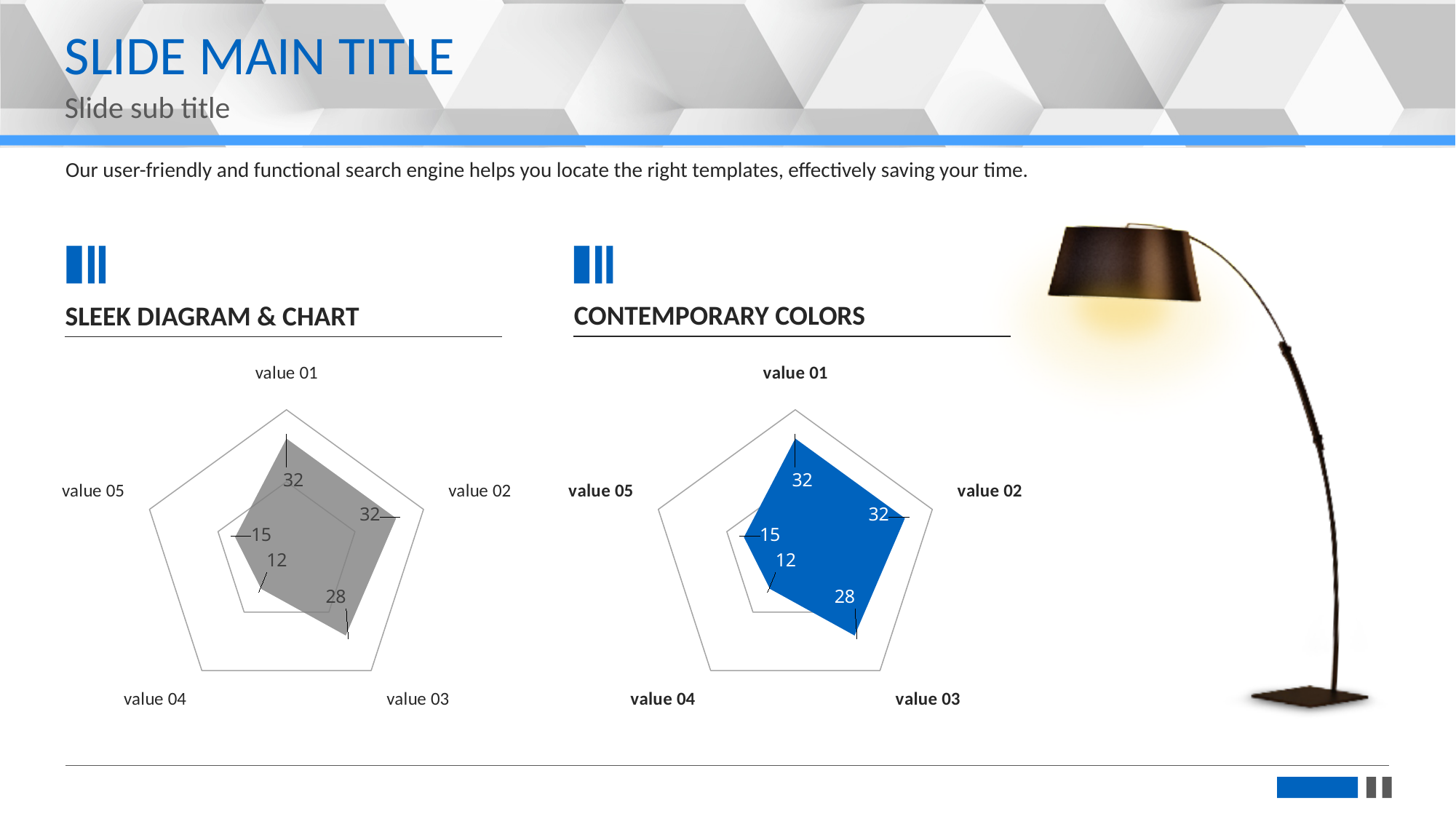
On the right chart under 'CONTEMPORARY COLORS', what is the value for value 04? 12 What colour is the data area in the right chart under 'CONTEMPORARY COLORS'? blue On the left chart under 'SLEEK DIAGRAM & CHART', which is larger, value 03 or value 05? value 03 On the left chart under 'SLEEK DIAGRAM & CHART', which category has the lowest value? value 04 On the right chart under 'CONTEMPORARY COLORS', which category has the lowest value? value 04 On the right chart under 'CONTEMPORARY COLORS', what is the value for value 01? 32 How many categories does the right chart under 'CONTEMPORARY COLORS' have? 5 On the left chart under 'SLEEK DIAGRAM & CHART', what is the value for value 05? 15 On the right chart under 'CONTEMPORARY COLORS', what is the difference between value 02 and value 03? 4 On the left chart under 'SLEEK DIAGRAM & CHART', what is the difference between value 05 and value 04? 3 What kind of chart is the left chart under 'SLEEK DIAGRAM & CHART'? radar chart On the left chart under 'SLEEK DIAGRAM & CHART', what is the value for value 03? 28